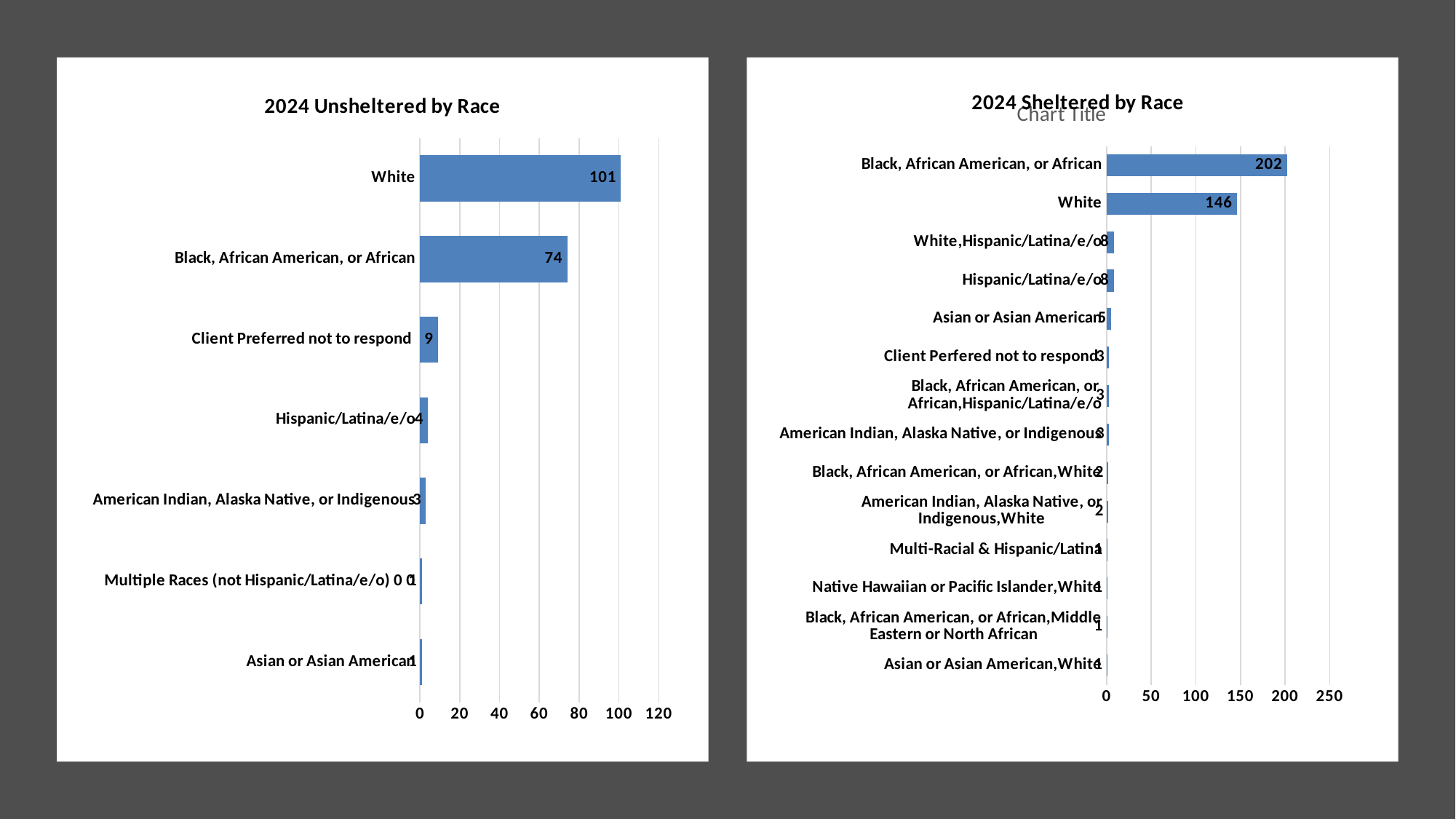
In the 2024 Unsheltered by Race chart, what is the value for Black, African American, or African? 74 In the 2024 Sheltered by Race chart, what is the difference between the values for Black, African American, or African and White? 56 In the 2024 Unsheltered by Race chart, what is the value for Client Preferred not to respond? 9 What kind of chart is the 2024 Unsheltered by Race chart? Bar chart In the 2024 Sheltered by Race chart, is the value for White greater or less than 100? greater In the 2024 Sheltered by Race chart, how many categories are plotted? 14 In the 2024 Sheltered by Race chart, what is the value for Black, African American, or African? 202 In the 2024 Unsheltered by Race chart, what is the difference between the values for White and Black, African American, or African? 27 In the 2024 Sheltered by Race chart, what is the value for White? 146 In the 2024 Unsheltered by Race chart, which category has the highest value? White In the 2024 Sheltered by Race chart, which category has the highest value? Black, African American, or African In the 2024 Unsheltered by Race chart, what is the value for White? 101